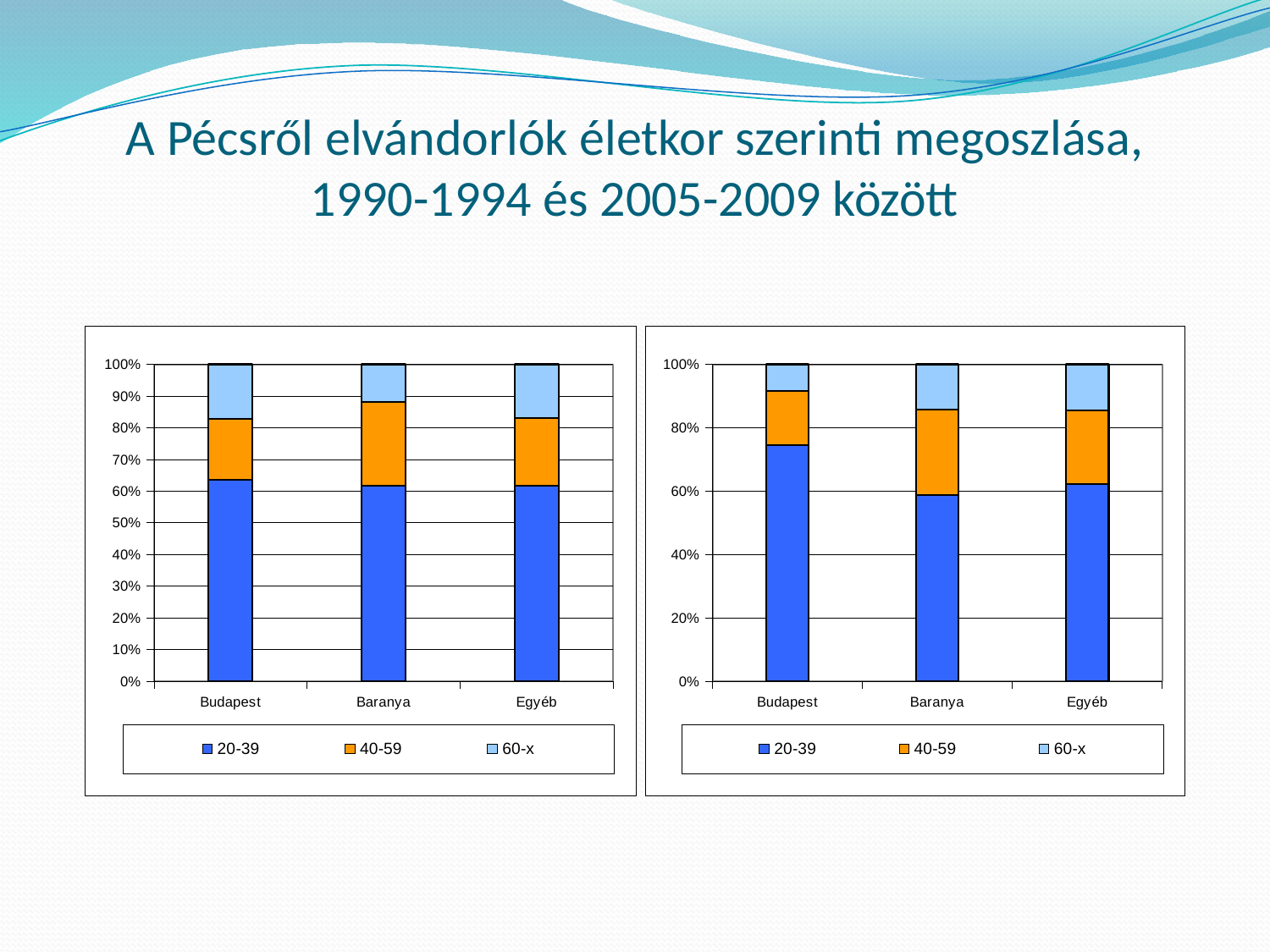
In the left chart, is the 20-39 share for Baranya greater or less than 70%? less In the right chart, which category has the largest 20-39 segment? Budapest In the right chart, which category has the smallest 60-x segment? Budapest In the left chart, which is larger for Budapest: the 20-39 segment or the 40-59 segment? 20-39 Which series is shown in orange in the legend of the right chart? 40-59 In the right chart, is the 20-39 share for Budapest greater or less than 60%? greater In the right chart, is the 20-39 share for Baranya greater or less than 80%? less How many categories are shown on the x axis of the right chart? 3 What is the label of the third category on the x axis of the left chart? Egyéb What kind of chart is the left chart on the slide? stacked bar chart In the right chart, which is larger for Budapest: the 40-59 segment or the 60-x segment? 40-59 How many series does the legend of the left chart list? 3